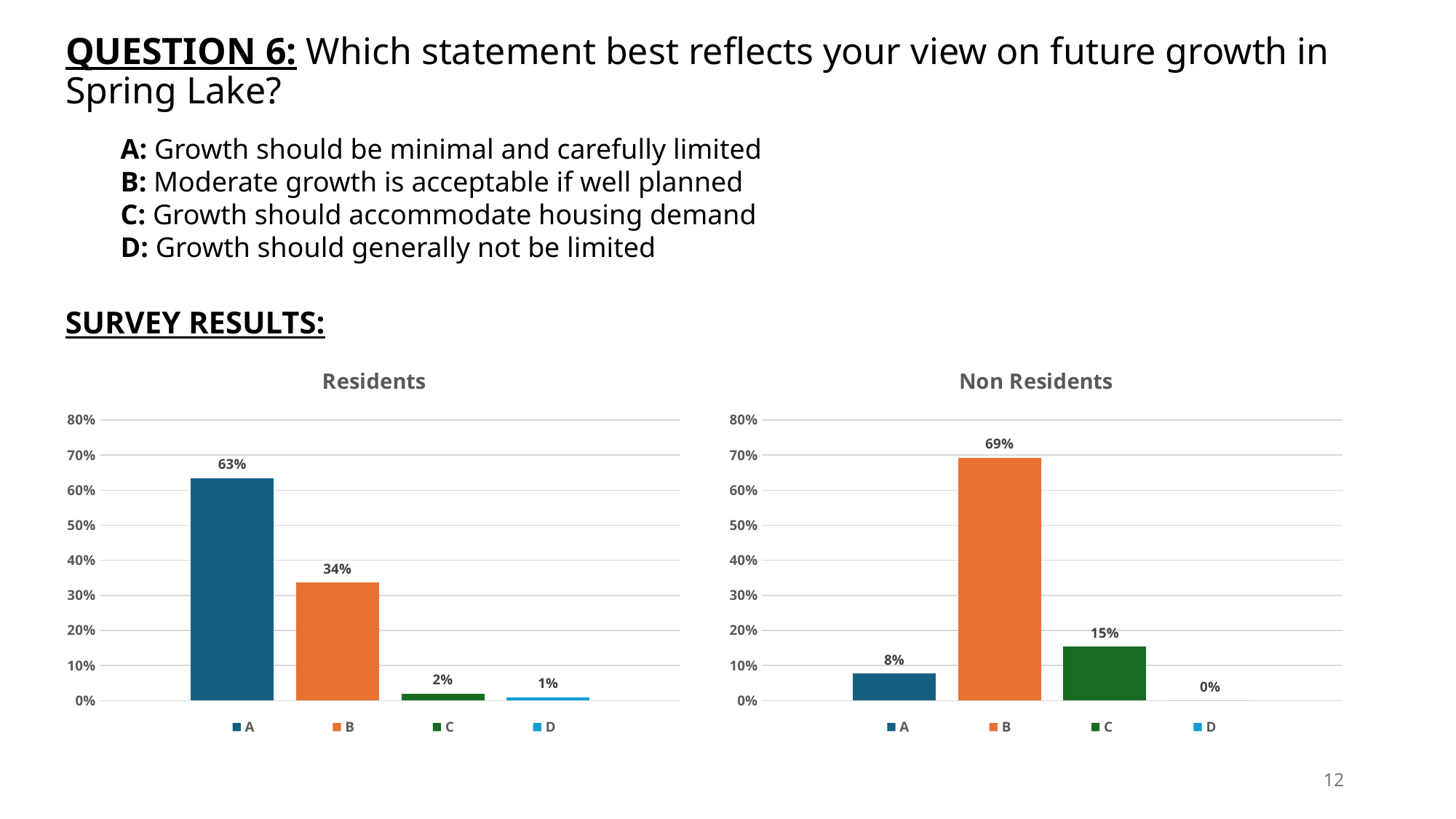
What is the title of the chart on the right side of the slide? Non Residents What kind of chart is the Non Residents chart? bar chart In the Non Residents chart, what is the difference between the values for B and C? 54% In the Residents chart, is the value for B greater or less than 40%? less In the Non Residents chart, what is the value for C? 15% In the Residents chart, which category has the highest value? A In the Non Residents chart, which is larger, the value for A or the value for C? C In the Non Residents chart, which category has the lowest value? D How many categories are shown in the Residents chart? 4 In the Non Residents chart, what is the value for B? 69% In the Residents chart, what is the difference between the values for A and B? 29% In the Residents chart, what is the value for A? 63%